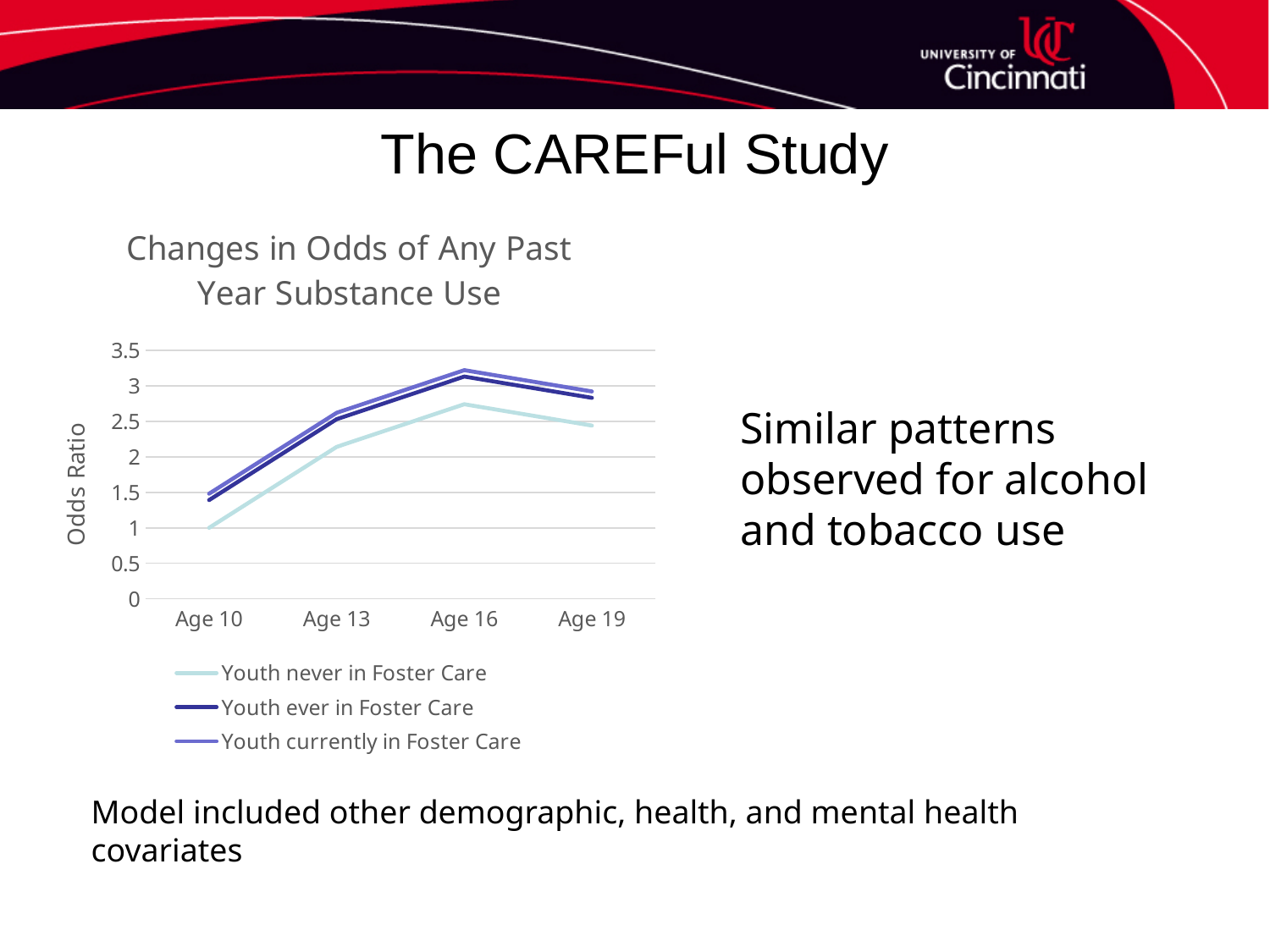
At which age is the odds ratio for Youth currently in Foster Care lowest? Age 10 Is the odds ratio for Youth ever in Foster Care at Age 10 greater or less than 1.5? less What is the title of the chart? Changes in Odds of Any Past Year Substance Use At Age 16, which series has the larger odds ratio: Youth never in Foster Care or Youth currently in Foster Care? Youth currently in Foster Care What kind of chart is shown on the slide? line chart What is the label on the y axis of the chart? Odds Ratio What is the odds ratio for Youth never in Foster Care at Age 10? 1 How many series does the chart's legend list? 3 Is the odds ratio for Youth currently in Foster Care at Age 16 greater or less than 3? greater Do the odds ratios for Youth never in Foster Care rise or fall from Age 10 to Age 16? rise How many age categories are shown on the x axis of the chart? 4 At which age is the odds ratio for Youth never in Foster Care highest? Age 16